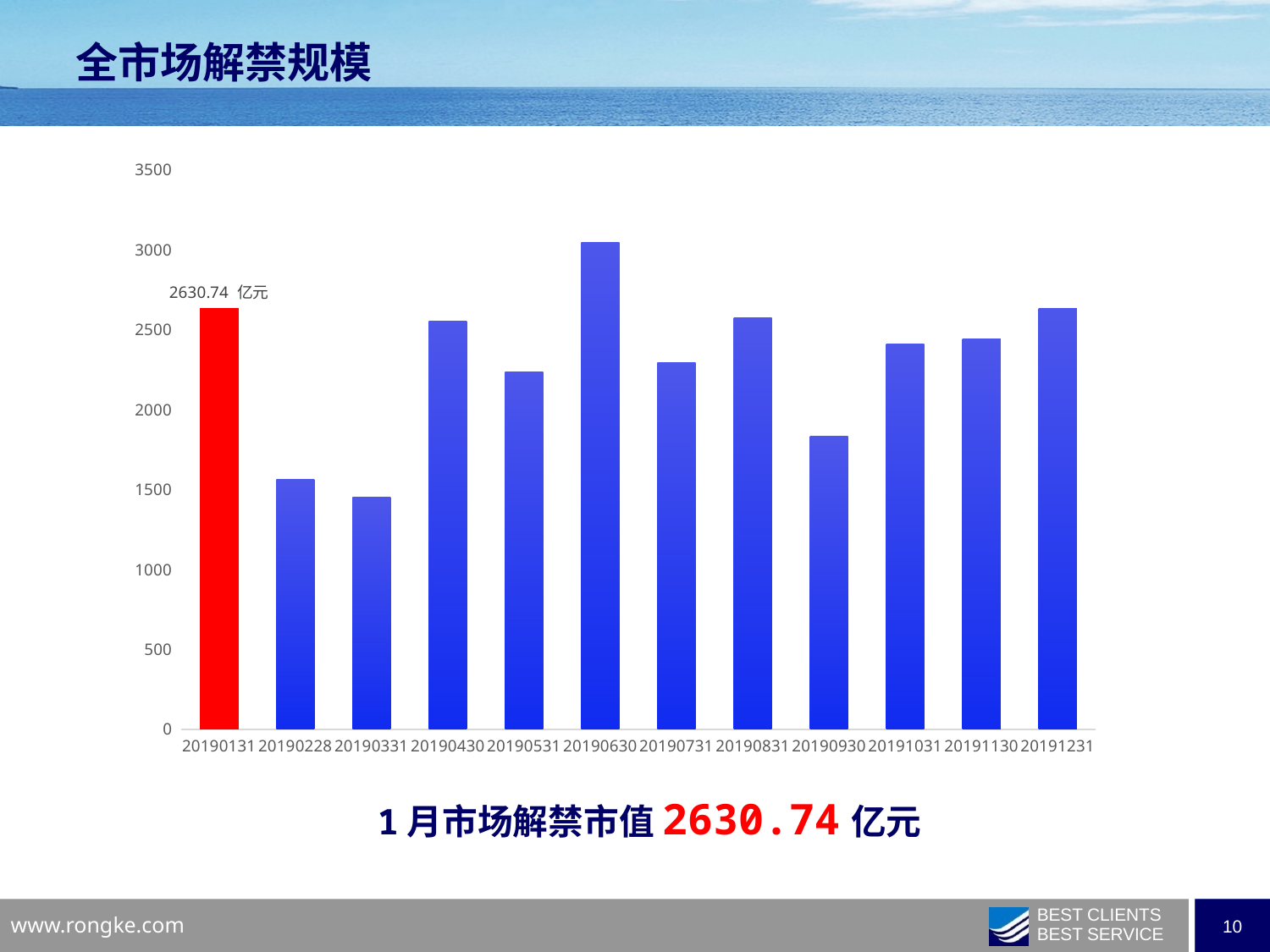
Which date has the highest bar? 20190630 Which is larger, the value for 20190228 or the value for 20190430? 20190430 Is the value for 20190630 greater or less than 3000? greater Which date has the lowest bar? 20190331 What is the value shown for 20190131? 2630.74 亿元 Which date's bar is coloured red? 20190131 Is the value for 20190430 greater or less than 2500? greater How many dates are shown on the x axis? 12 Which is larger, the value for 20190630 or the value for 20190930? 20190630 Is the value for 20190930 greater or less than 2000? less What kind of chart is shown on the slide? bar chart